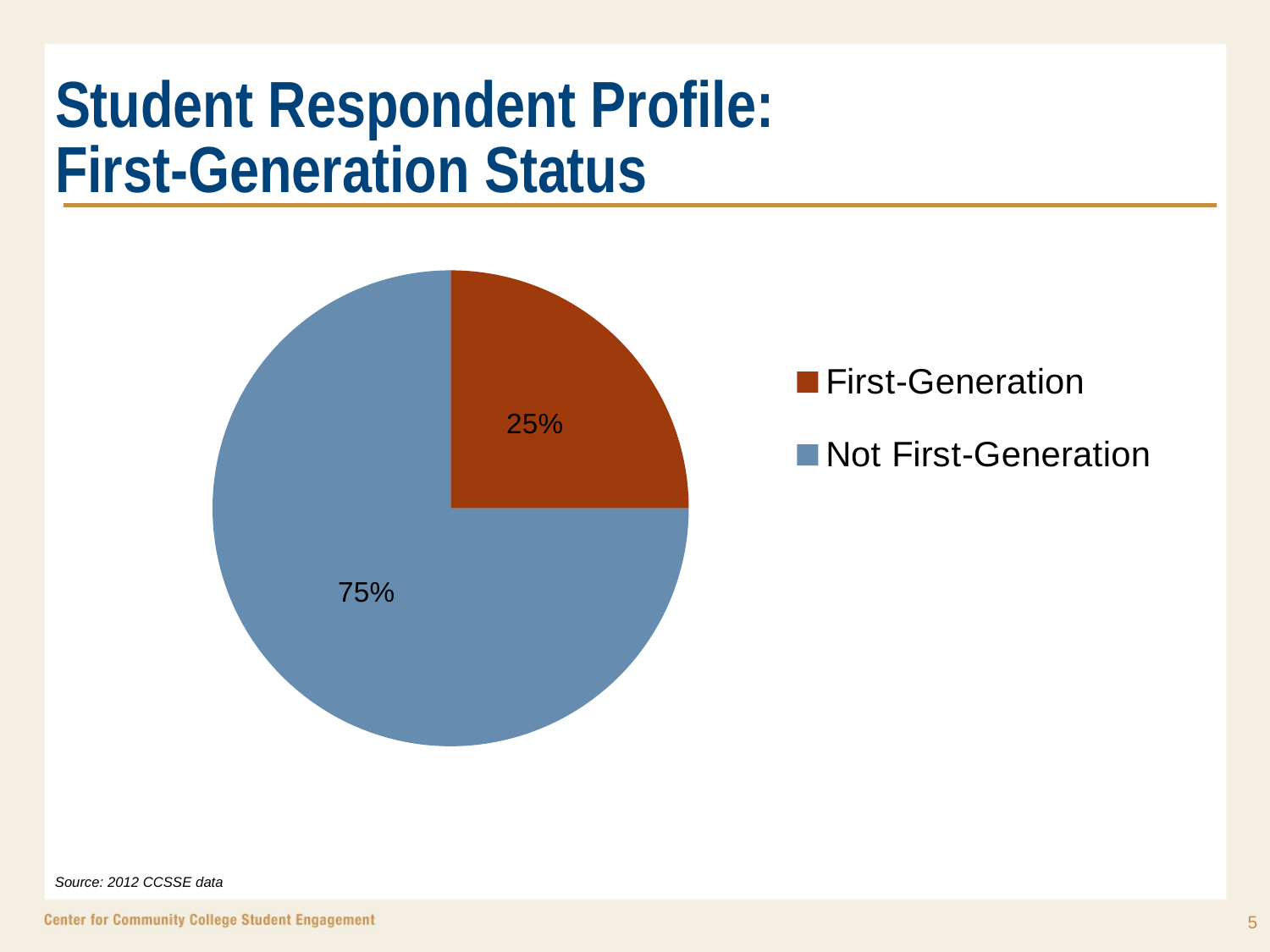
What colour is the First-Generation slice? orange-brown How many entries does the legend list? 2 What kind of chart is shown on the slide? pie chart What is the difference in percentage points between Not First-Generation and First-Generation? 50 Which is larger: the share for First-Generation or the share for Not First-Generation? Not First-Generation What share of the pie does the First-Generation slice represent? 25% Which category has the smallest share of the pie? First-Generation What is the title of the slide containing the chart? Student Respondent Profile: First-Generation Status Which category has the largest share of the pie? Not First-Generation What percentage of respondents are First-Generation? 25% How many slices does the pie chart have? 2 What percentage of respondents are Not First-Generation? 75%